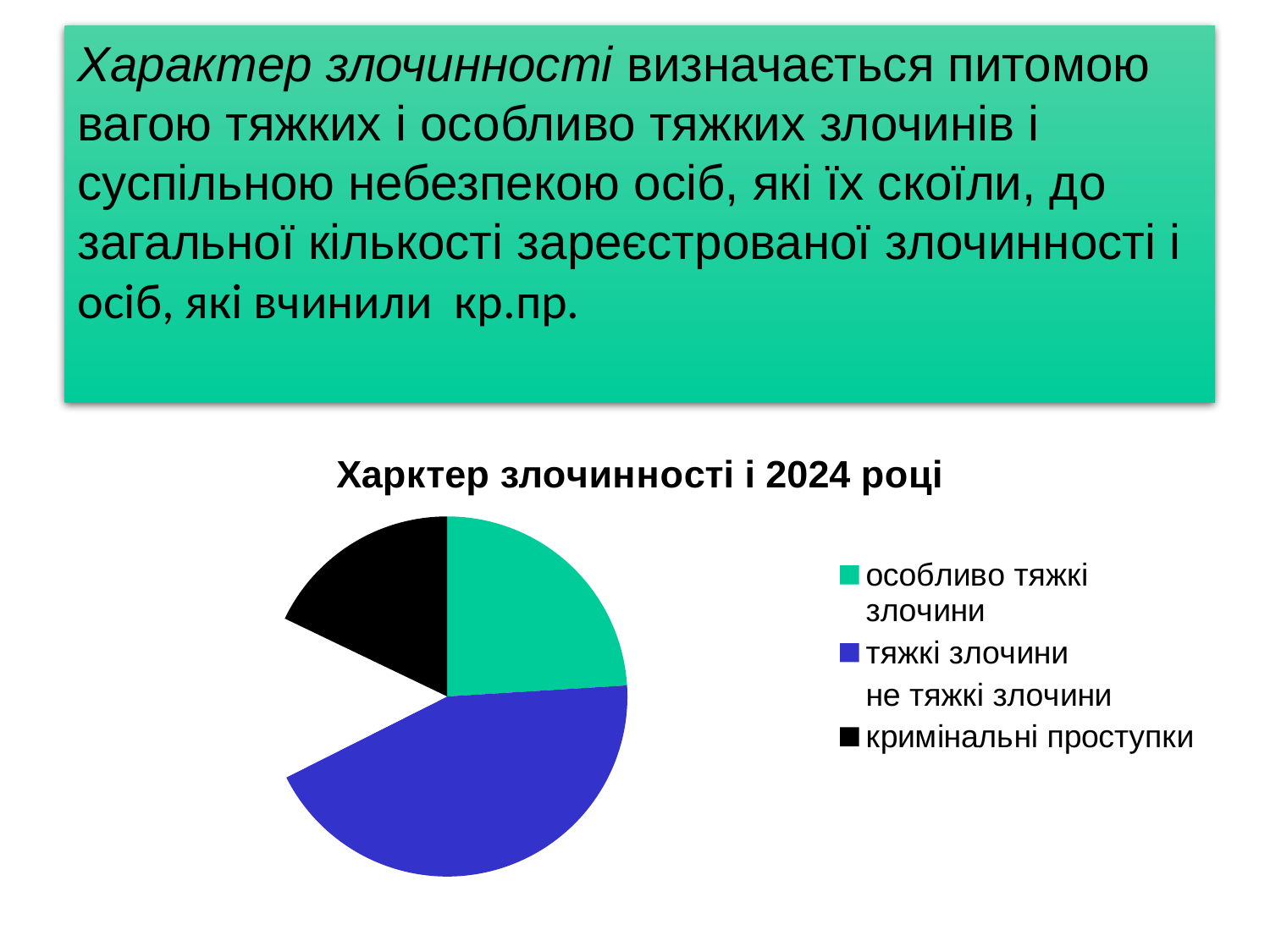
How many slices does the pie chart have? 4 What is the title of the chart? Харктер злочинності і 2024 році Which category is shown in black in the pie chart? кримінальні проступки How many categories does the legend of the pie chart list? 4 Which year does the chart title refer to? 2024 What kind of chart is shown on the slide? pie chart Which slice is larger: особливо тяжкі злочини or тяжкі злочини? тяжкі злочини Which slice is larger: тяжкі злочини or кримінальні проступки? тяжкі злочини Which slice is larger: особливо тяжкі злочини or кримінальні проступки? особливо тяжкі злочини Which category has the largest slice of the pie chart? тяжкі злочини